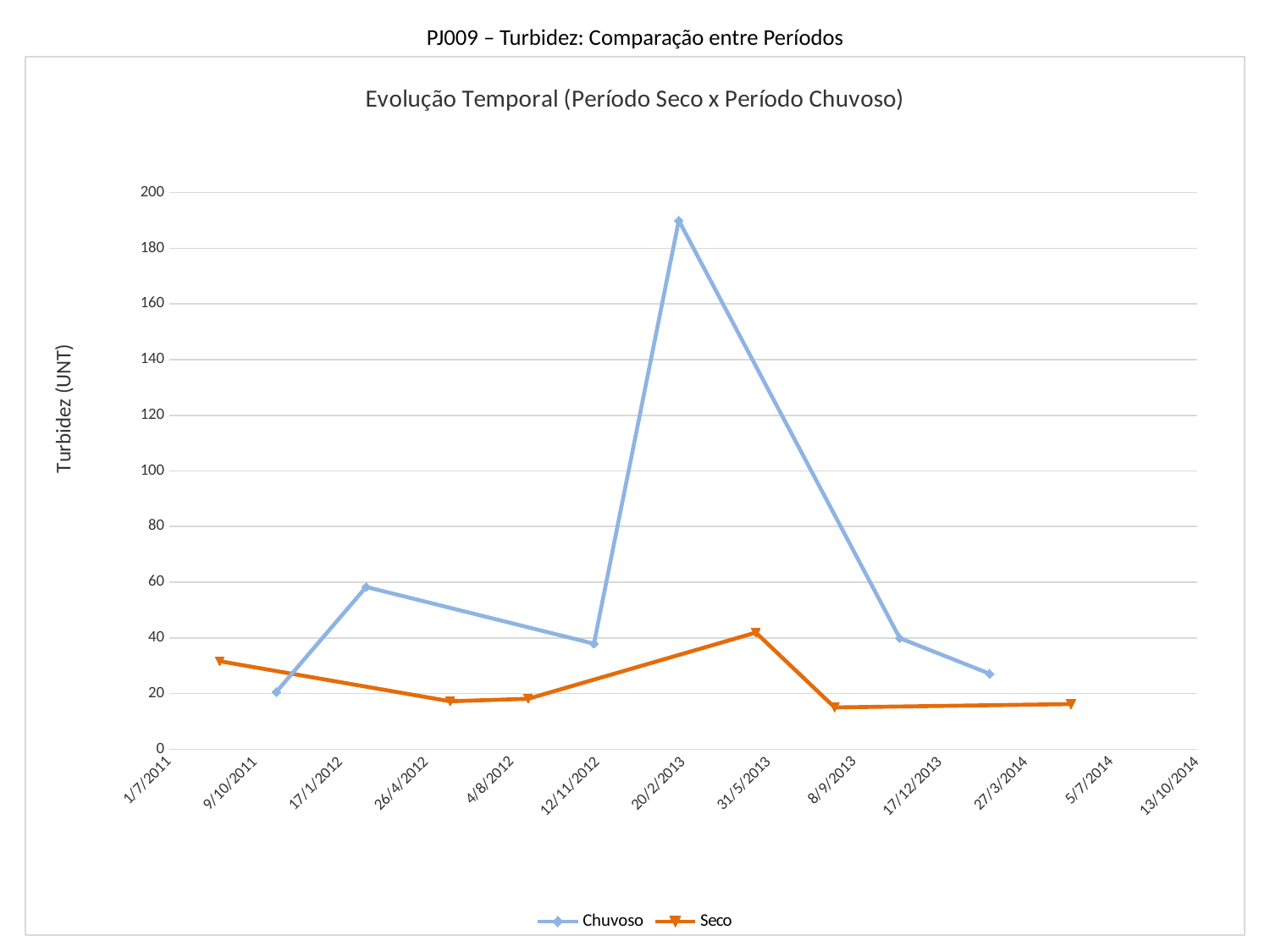
Is the last plotted value of the Seco series greater or less than 20? less Is the first plotted value of the Chuvoso series greater or less than 40? less What are the two series named in the legend? Chuvoso and Seco How many data points are plotted for the Seco series? 6 Is the highest value of the Seco series greater or less than 60? less What kind of chart is shown on the slide? line chart How many series does the legend list? 2 After reaching its peak, does the Chuvoso line rise or fall? fall How many data points are plotted for the Chuvoso series? 6 Which series reaches the highest value on the chart? Chuvoso What is the label on the vertical axis? Turbidez (UNT)